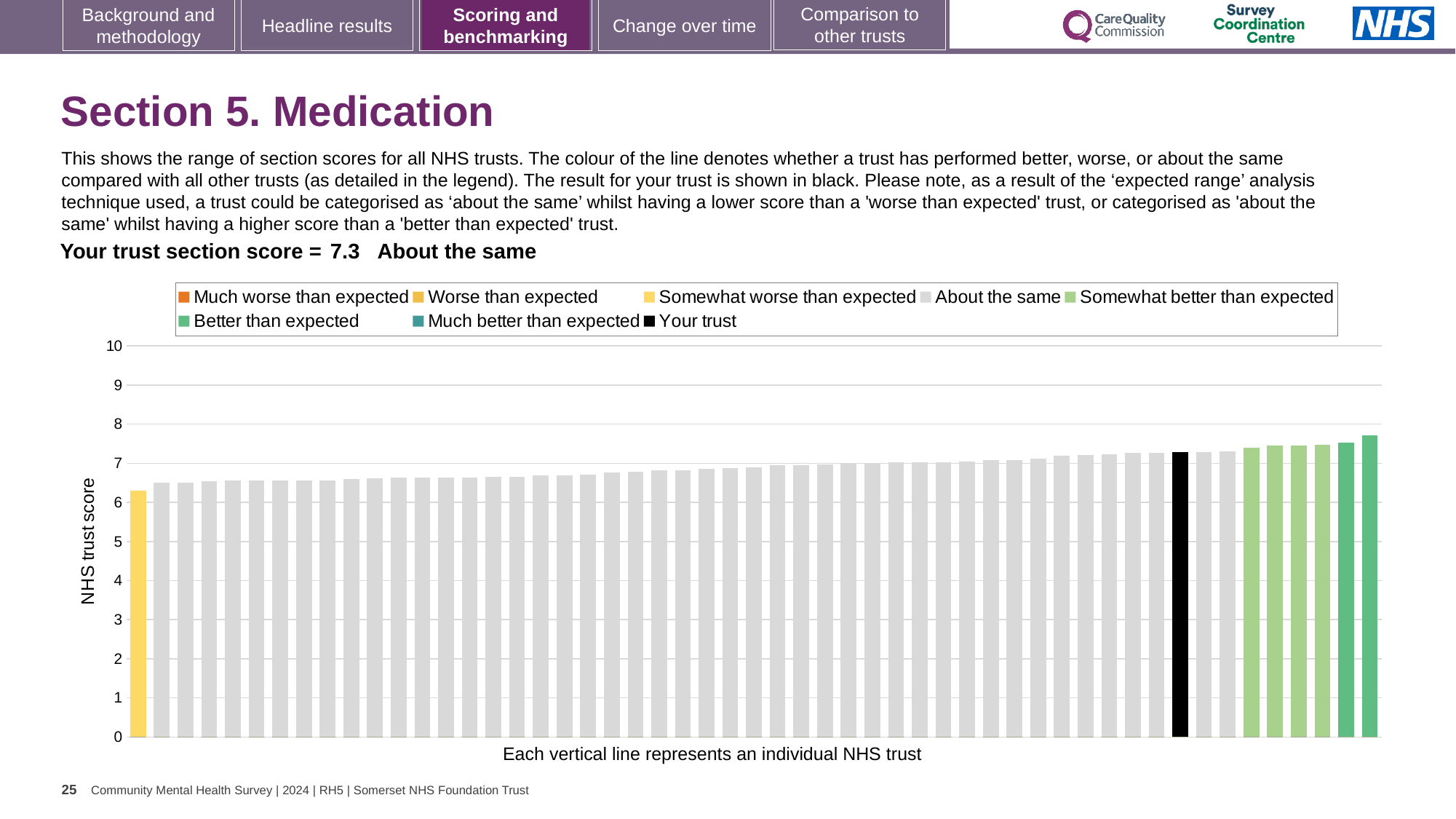
Which performance category is your trust placed in for this section? About the same What kind of chart is shown on the slide? bar chart Which is taller: the black 'Your trust' bar or the rightmost bar? the rightmost bar Is the value of the tallest bar on the chart greater or less than 8? less What is the label on the vertical axis of the chart? NHS trust score What is the section score for your trust, as printed on the slide? 7.3 Do the bar values rise or fall moving from left to right along the x axis? rise Is the value of the black 'Your trust' bar greater or less than 7? greater Is the value of the leftmost (yellow) bar greater or less than 7? less How many entries does the chart legend list? 8 What colour is used for the 'Your trust' bar according to the legend? black